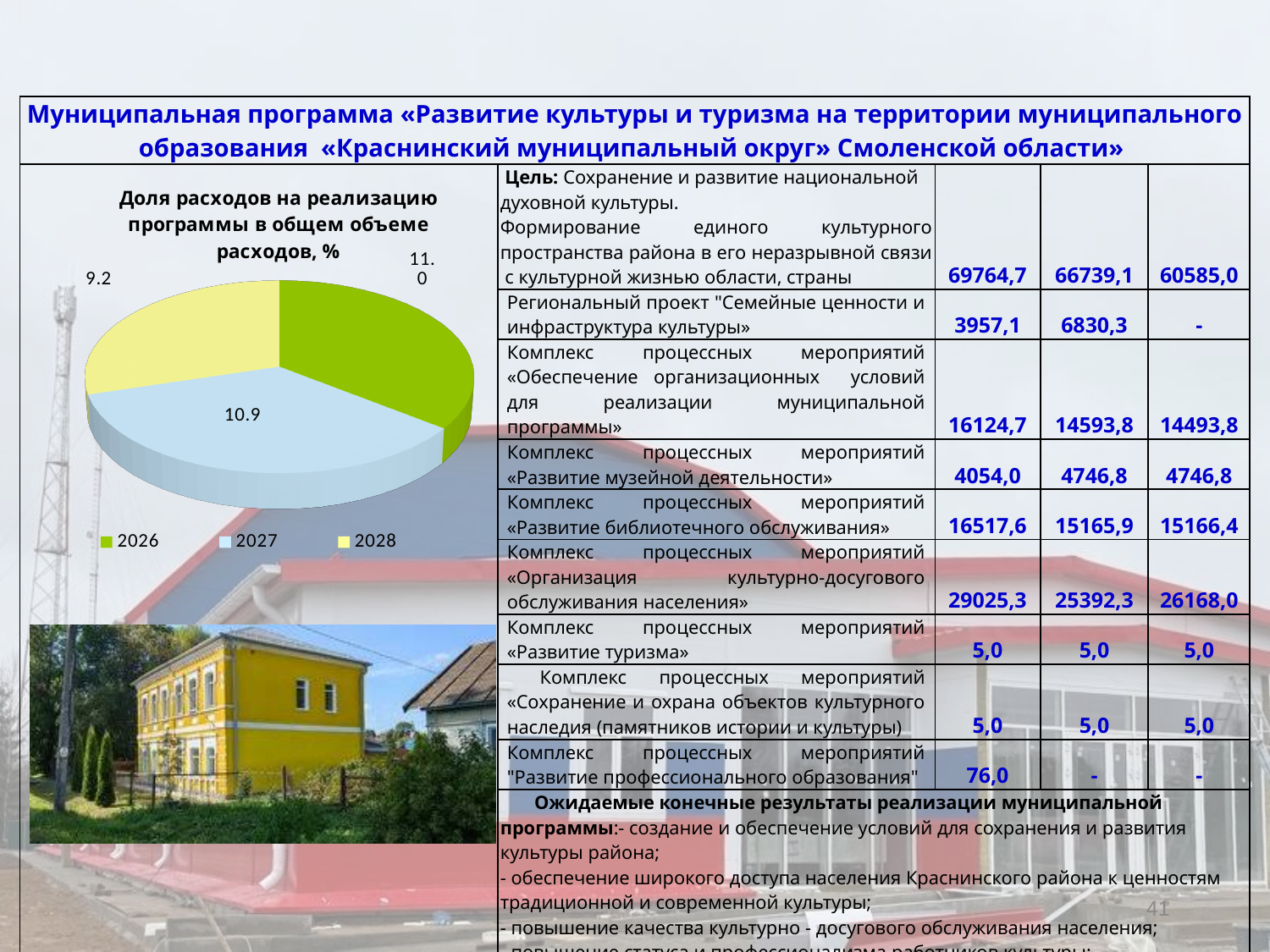
What is the title of the pie chart? Доля расходов на реализацию программы в общем объеме расходов, % What value is shown for 2026 in the pie chart? 11.0 What type of chart is shown on the slide? Pie chart What is the difference between the values for 2027 and 2028 in the pie chart? 1.7 Which year has the largest share in the pie chart? 2026 How many slices does the pie chart have? 3 What value is shown for 2028 in the pie chart? 9.2 How many entries does the legend of the pie chart list? 3 Which is larger in the pie chart, the value for 2027 or the value for 2028? 2027 What value is shown for 2027 in the pie chart? 10.9 What is the difference between the values for 2026 and 2028 in the pie chart? 1.8 Which year has the smallest share in the pie chart? 2028